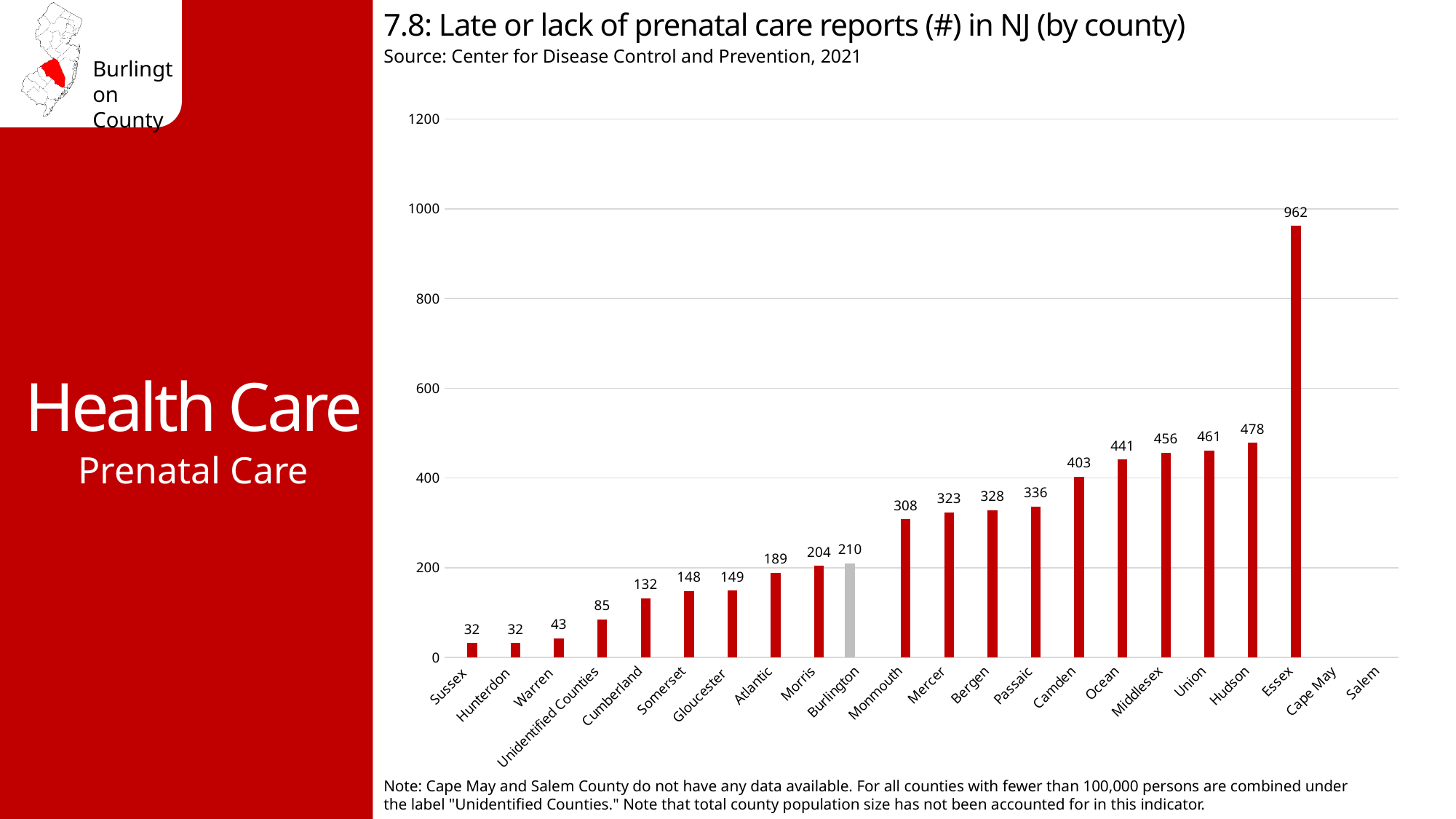
Which county has the highest number of late or lack of prenatal care reports? Essex Do the values generally rise or fall from Sussex to Essex along the x axis? Rise What is the number of late or lack of prenatal care reports for Burlington? 210 Which bar is coloured grey instead of red? Burlington What kind of chart is shown on the slide? Bar chart What is the value shown for Unidentified Counties? 85 What is the difference between the values for Hudson and Burlington? 268 What is the value shown for Essex? 962 What is the value shown for Camden? 403 Is the value for Ocean greater or less than 400? greater Which has a larger value, Mercer or Morris? Mercer How many counties (categories) are listed along the x axis? 22